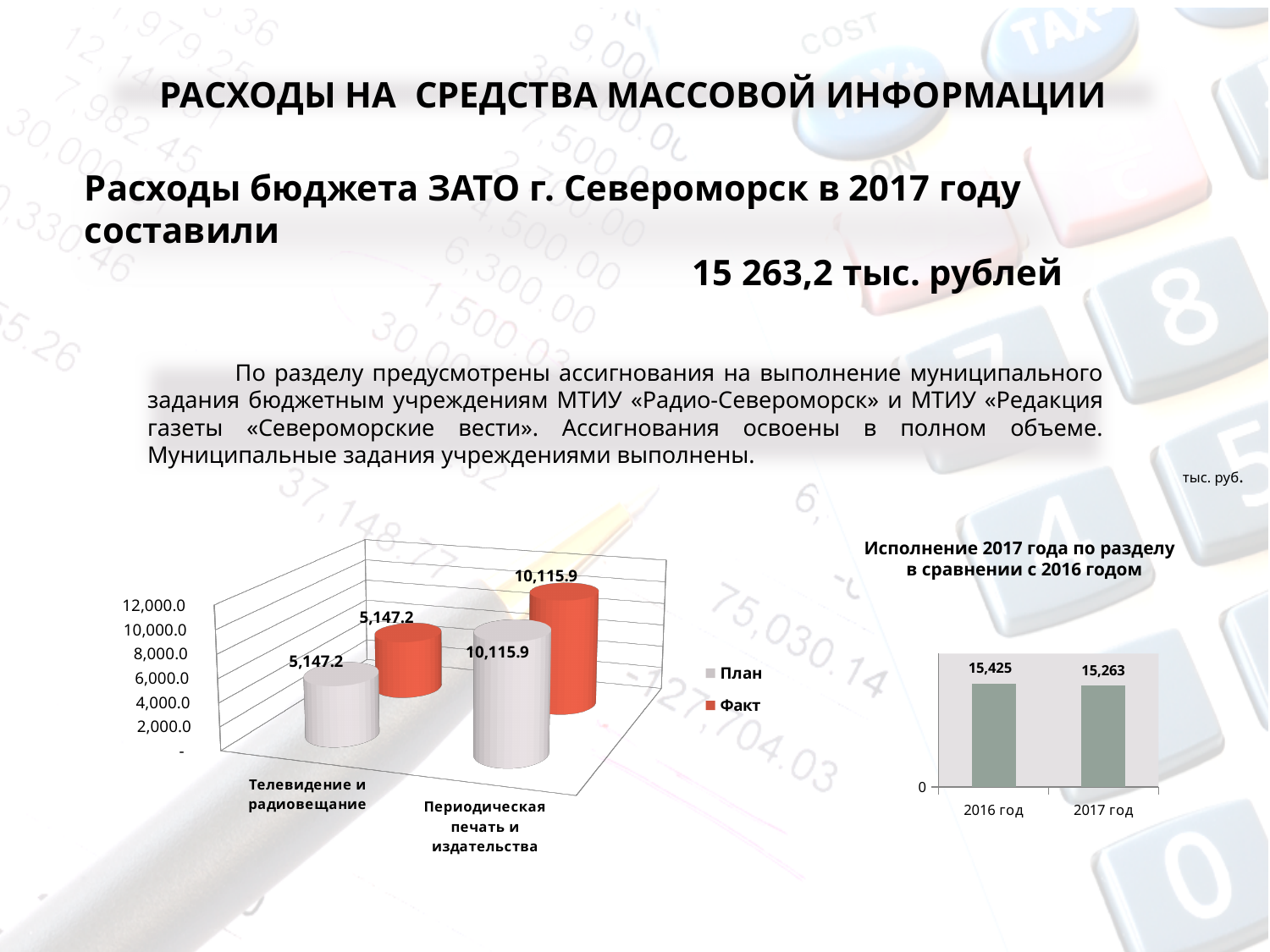
In the chart titled 'Исполнение 2017 года по разделу в сравнении с 2016 годом', what is the value for 2017 год? 15,263 In the left chart, which category has the larger Факт value, Телевидение и радиовещание or Периодическая печать и издательства? Периодическая печать и издательства In the left chart, how many categories are shown on the x axis? 2 What kind of chart is the left chart? bar chart In the left chart, how many series does the legend list? 2 In the left chart, what is the План value for Телевидение и радиовещание? 5,147.2 In the left chart, what is the Факт value for Периодическая печать и издательства? 10,115.9 In the chart titled 'Исполнение 2017 года по разделу в сравнении с 2016 годом', what is the difference between the 2016 год and 2017 год values? 162 In the left chart, what are the two legend entries? План, Факт In the chart titled 'Исполнение 2017 года по разделу в сравнении с 2016 годом', do the values rise or fall from 2016 год to 2017 год? fall In the chart titled 'Исполнение 2017 года по разделу в сравнении с 2016 годом', what is the value for 2016 год? 15,425 In the left chart, what is the difference between the План values for Периодическая печать и издательства and Телевидение и радиовещание? 4,968.7